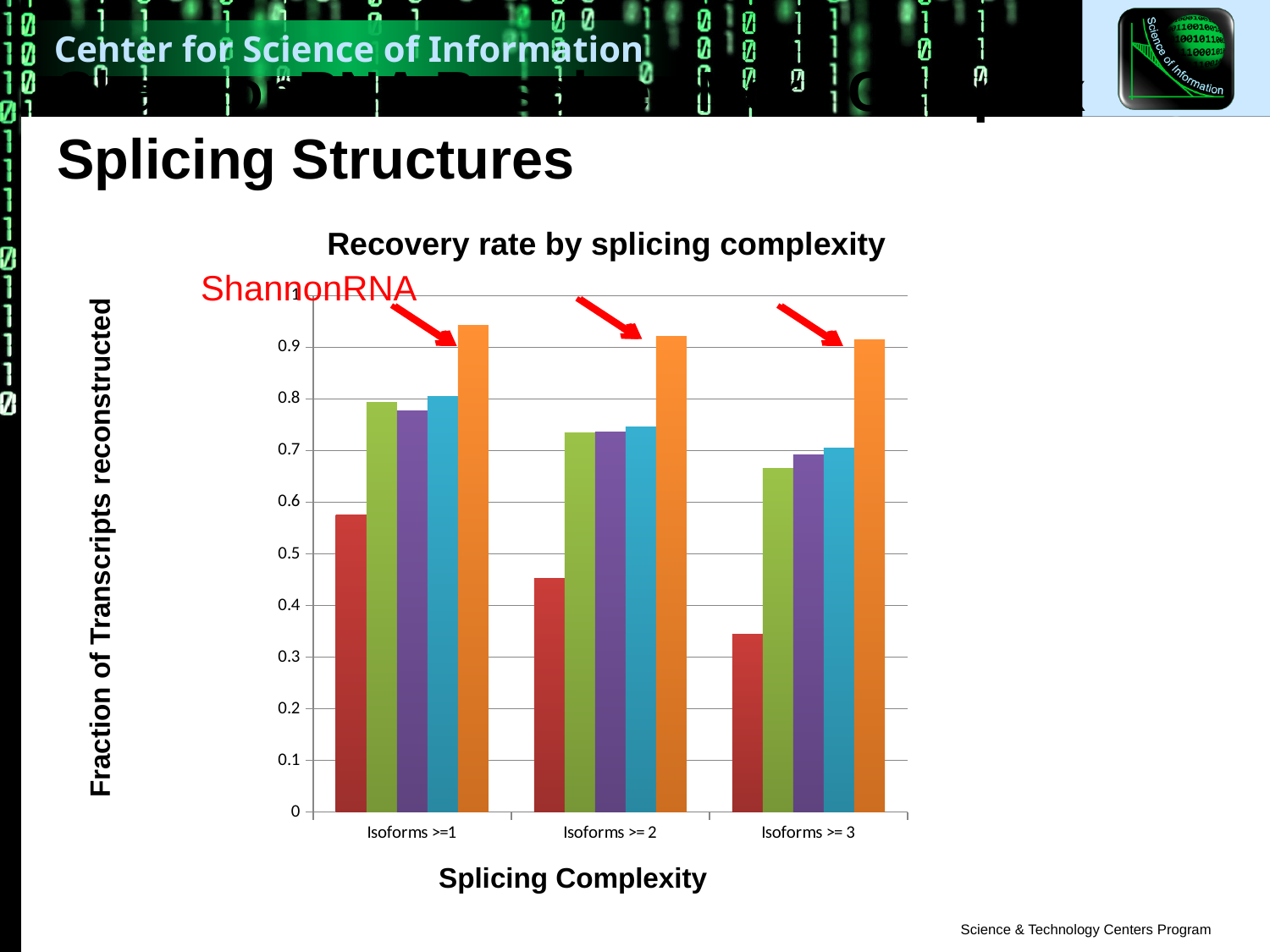
Do the red bars rise or fall as splicing complexity increases from Isoforms >=1 to Isoforms >= 3? fall What is the label of the y axis? Fraction of Transcripts reconstructed For Isoforms >= 2, which is larger: the ShannonRNA (orange) bar or the red bar? ShannonRNA (orange) bar Is the red bar for Isoforms >= 3 greater or less than 0.4? less What kind of chart is shown on the slide? bar chart What is the title of the chart? Recovery rate by splicing complexity Is the red bar for Isoforms >= 2 greater or less than 0.5? less For which splicing complexity category is the red bar lowest? Isoforms >= 3 How many bars are plotted for each splicing complexity category? 5 Is the ShannonRNA (orange) value for Isoforms >=1 greater or less than 0.9? greater How many splicing complexity categories are shown on the x axis? 3